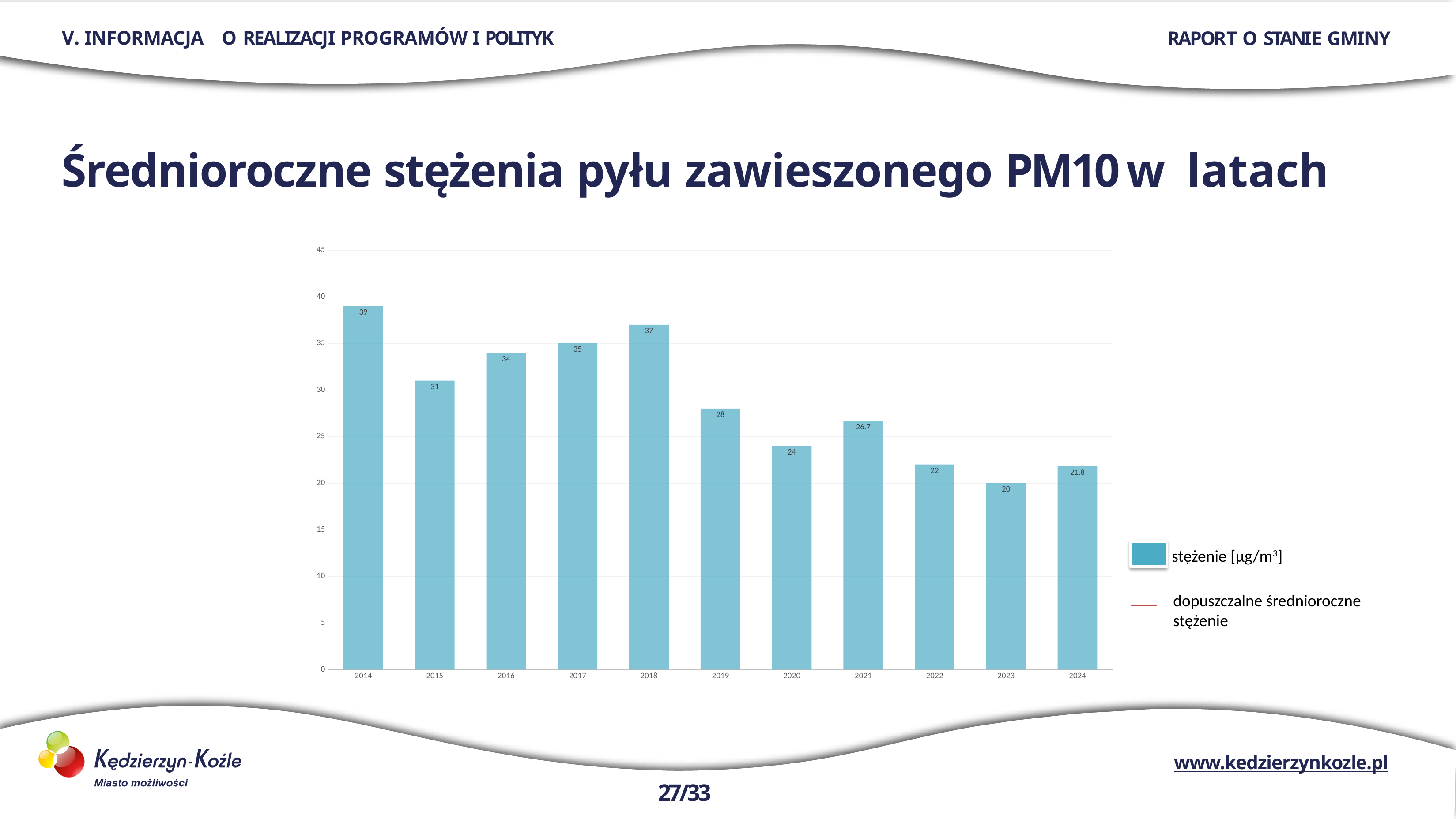
What is the PM10 concentration value shown for 2024? 21.8 Do the PM10 concentration values generally rise or fall from 2014 to 2024? fall How many years are shown on the x axis of the chart? 11 Which year has a higher PM10 concentration, 2018 or 2019? 2018 What is the PM10 concentration value shown for 2021? 26.7 How many entries does the legend list? 2 What is the difference between the PM10 concentration in 2014 and in 2023? 19 Is the value for 2020 greater or less than 25? less Which year has the lowest PM10 concentration? 2023 Which year has the highest PM10 concentration? 2014 What is the PM10 concentration value shown for 2014? 39 What kind of chart is shown on the slide? bar chart